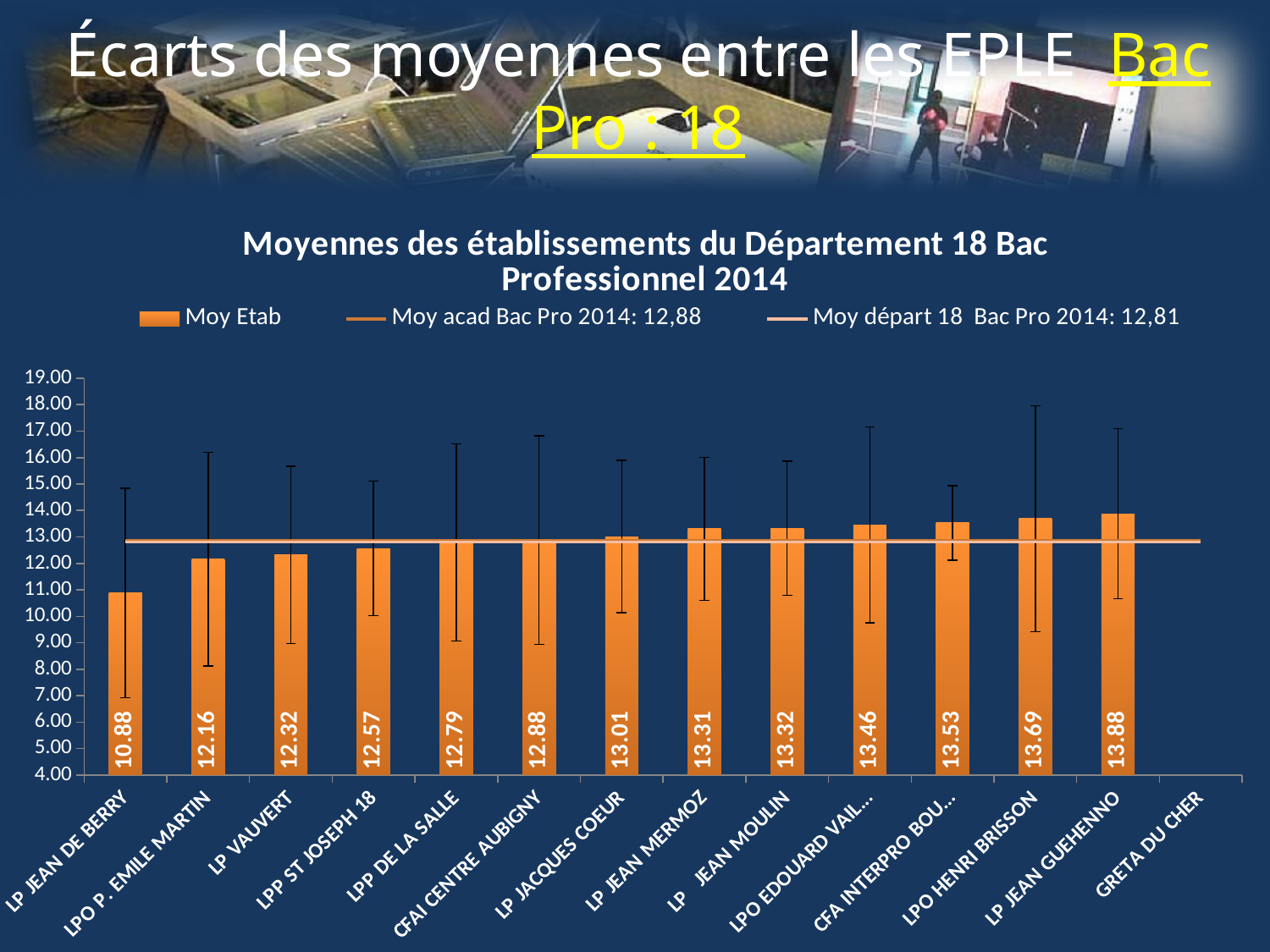
Is the value for LP JEAN DE BERRY greater or less than 12.00? less Which establishment has the highest value? LP JEAN GUEHENNO What is the value for LP JEAN GUEHENNO? 13.88 What is the difference between the values for LP JEAN GUEHENNO and LP JEAN DE BERRY? 3.00 What value does the legend give for Moy acad Bac Pro 2014? 12,88 What is the value for LPO HENRI BRISSON? 13.69 Which establishment has the lowest value? LP JEAN DE BERRY How many series does the legend list? 3 What kind of chart is shown? bar chart Do the bar values rise or fall from left to right along the x axis? rise Which is larger, the value for LP VAUVERT or for LPP ST JOSEPH 18? LPP ST JOSEPH 18 What is the value for LP JEAN DE BERRY? 10.88